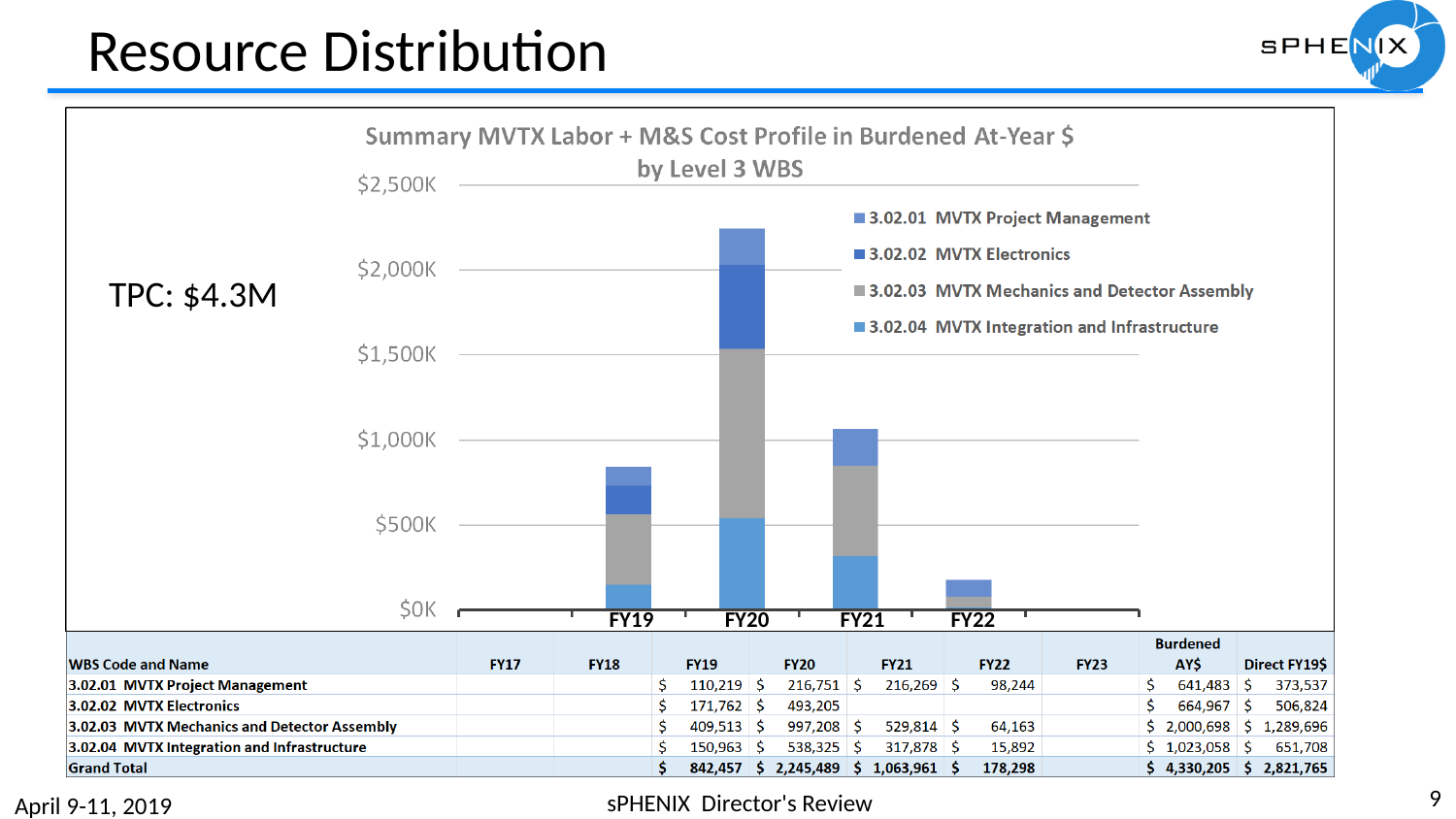
Which series in the legend is shown in gray? 3.02.03 MVTX Mechanics and Detector Assembly How many series does the chart legend list? 4 What kind of chart is shown on the slide? Stacked bar chart Is the total stacked bar for FY19 greater or less than $1,000K? less Is the total stacked bar for FY20 greater or less than $2,000K? greater Which stacked bar is taller, FY19 or FY21? FY21 According to the table below the chart, what is the FY19 value for 3.02.01 MVTX Project Management? $ 110,219 Which fiscal year has the shortest stacked bar? FY22 Which fiscal year has the tallest stacked bar? FY20 Using the Grand Total row of the table, what is the difference between the FY20 and FY21 totals? 1,181,528 How many fiscal years are labeled on the chart's x axis? 4 According to the table below the chart, what is the Grand Total for FY20? $ 2,245,489